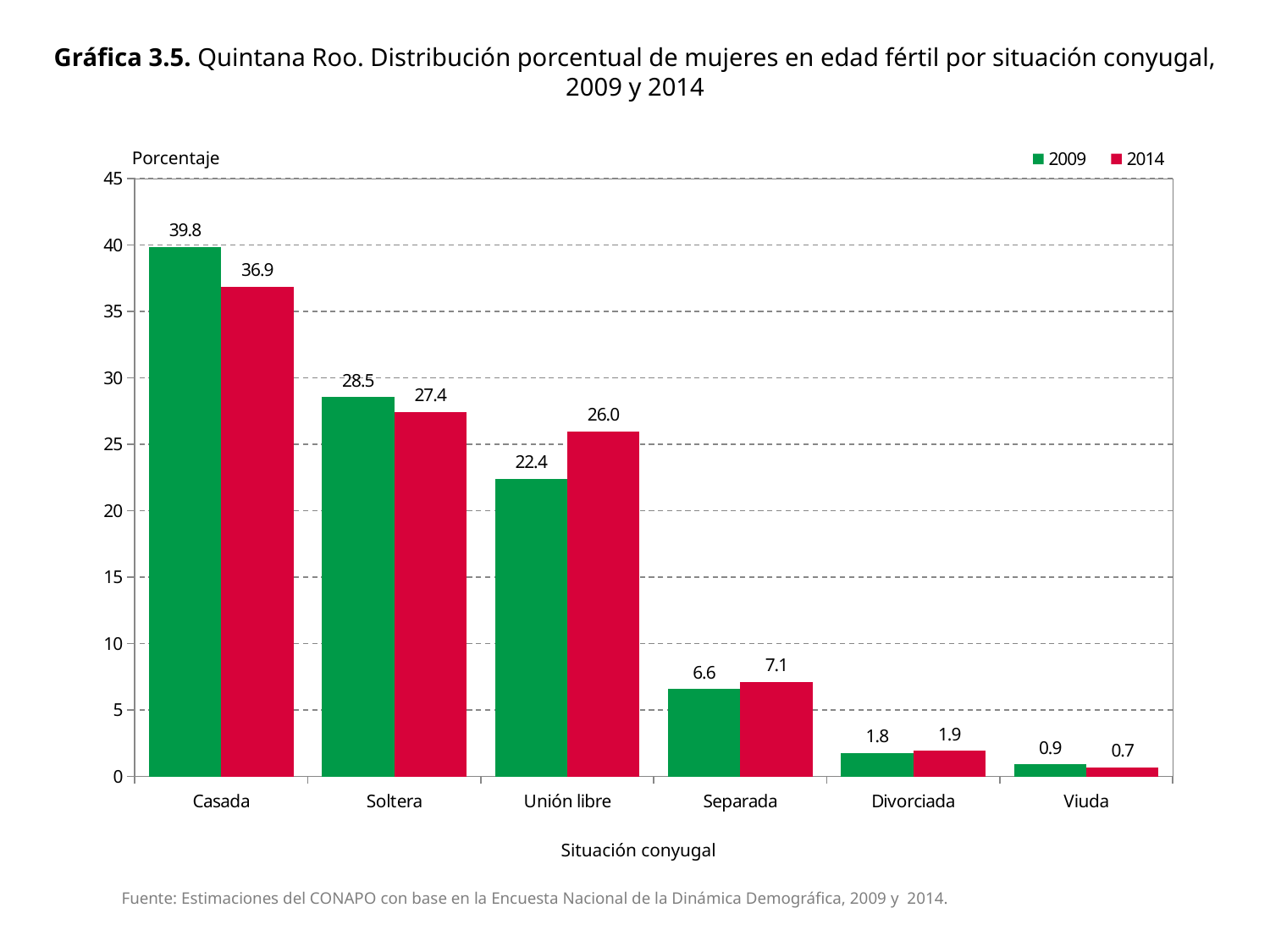
How many categories are shown on the x axis? 6 What is the difference between the 2014 values for Soltera and Unión libre? 1.4 Which category has the lowest value in 2009? Viuda How many series does the legend list? 2 What is the value for Unión libre in 2014? 26.0 What is the value for Casada in 2009? 39.8 What kind of chart is shown on the slide? bar chart Is the 2009 value for Soltera greater or less than 25? greater What is the value for Viuda in 2014? 0.7 What is the difference between the 2009 and 2014 values for Casada? 2.9 Which is larger for Unión libre, the 2009 value or the 2014 value? 2014 Which category has the highest value in 2014? Casada